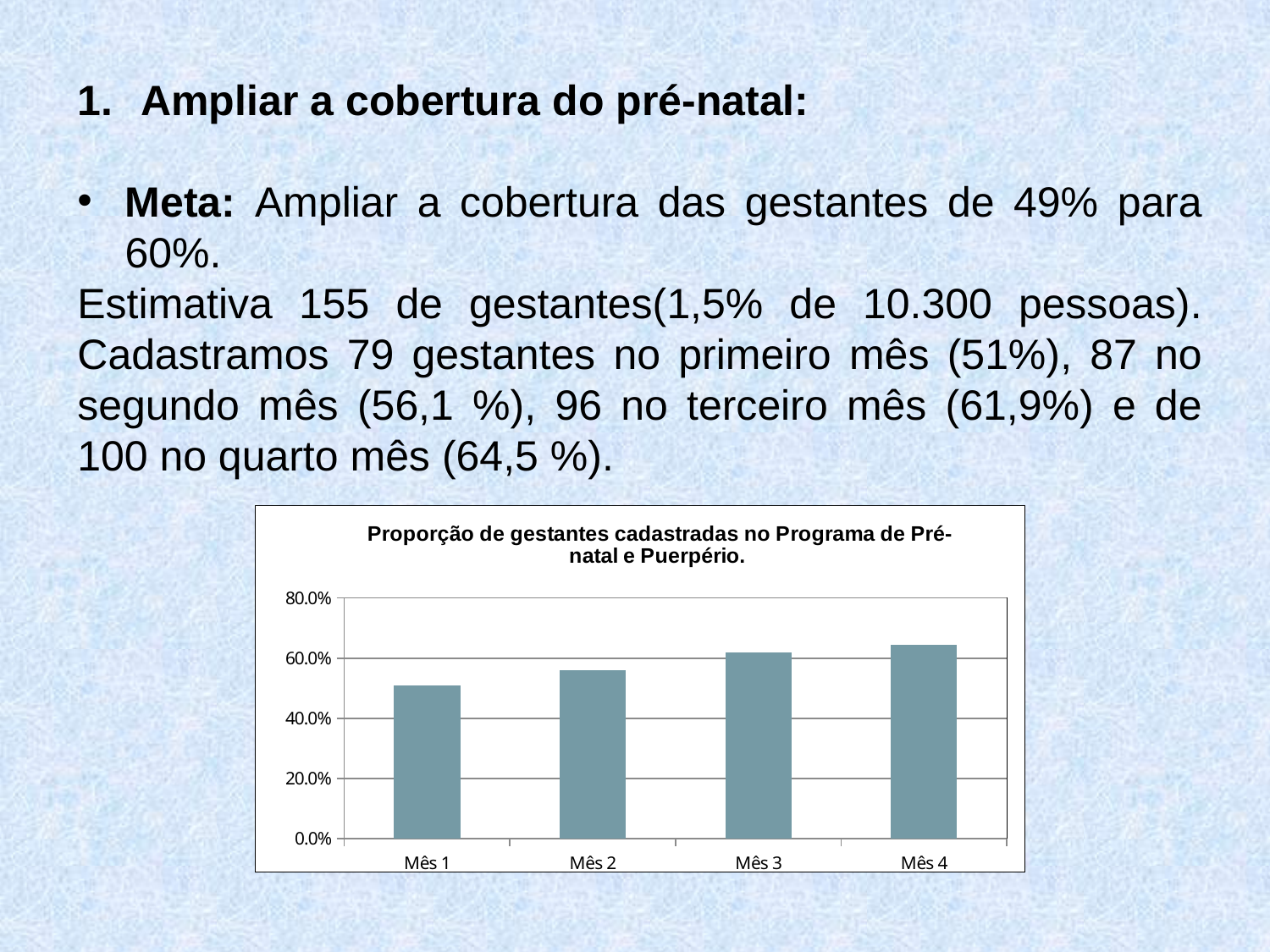
Which month has the highest bar in the chart? Mês 4 Do the values rise or fall from Mês 1 to Mês 4? rise Which month has the lowest bar in the chart? Mês 1 Is the value for Mês 2 greater or less than 60.0%? less What kind of chart is shown on the slide? bar chart How many categories (months) are shown on the x axis of the chart? 4 Is the value for Mês 1 greater or less than 40.0%? greater What is the title of the chart? Proporção de gestantes cadastradas no Programa de Pré-natal e Puerpério. Which is larger, the value for Mês 1 or the value for Mês 2? Mês 2 Is the value for Mês 3 greater or less than 60.0%? greater